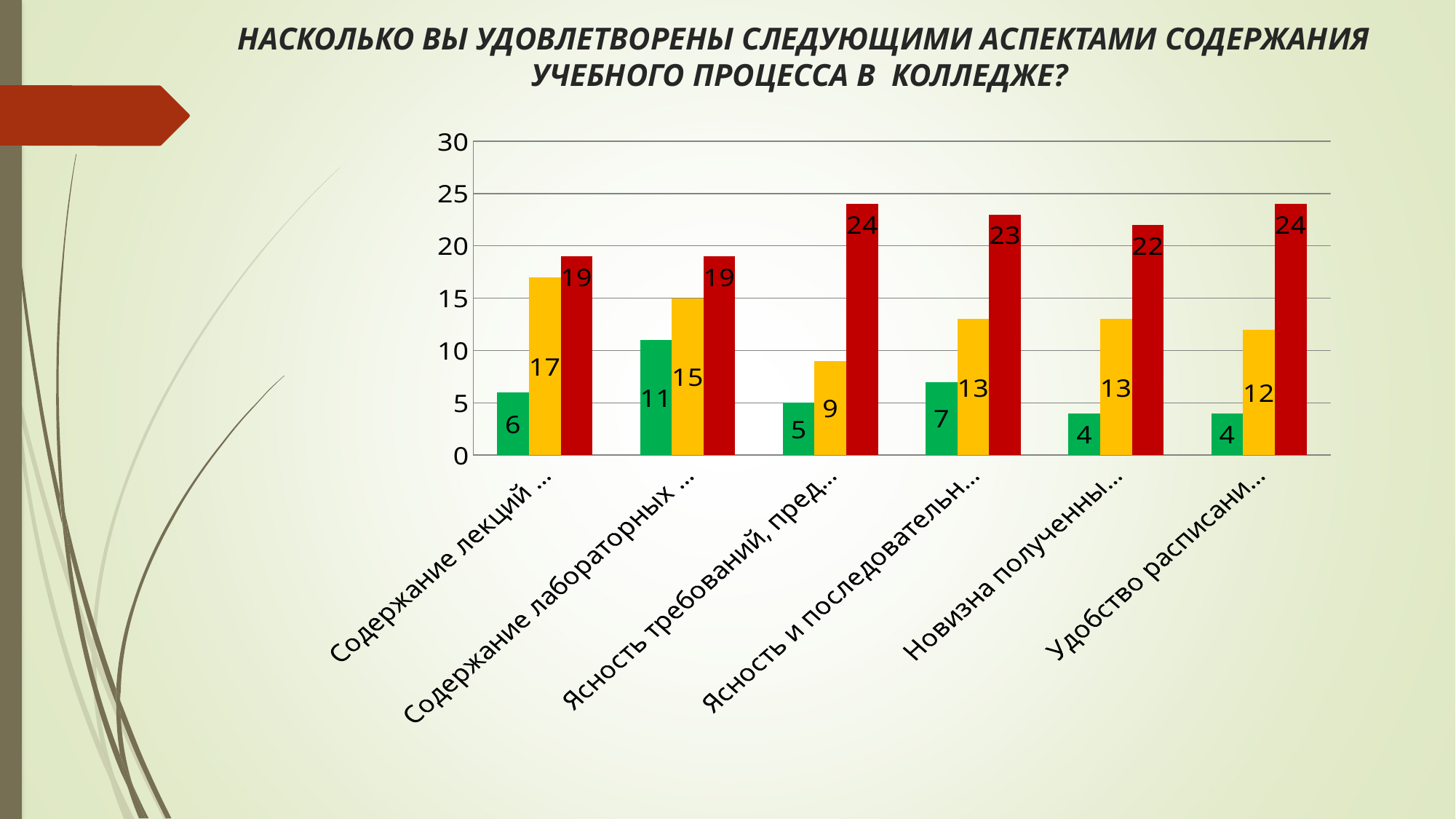
How many categories are shown on the x axis of the chart? 6 How many bars are shown for each category in the chart? 3 What is the value of the yellow bar for the category "Содержание лабораторных ..."? 15 Which is larger for the category "Содержание лекций ...": the yellow bar or the red bar? the red bar What is the value of the yellow bar for the category "Новизна полученны..."? 13 What is the value of the red bar for the category "Ясность требований, пред..."? 24 What type of chart is shown on the slide? bar chart Is the value of the red bar for "Ясность и последовательн..." greater or less than 20? greater Which category has the lowest red bar? Содержание лекций ... and Содержание лабораторных ... (both 19) What is the value of the green bar for the category "Содержание лекций ..."? 6 Which category has the highest green bar? Содержание лабораторных ... What is the difference between the red bar and the green bar for the category "Удобство расписани..."? 20